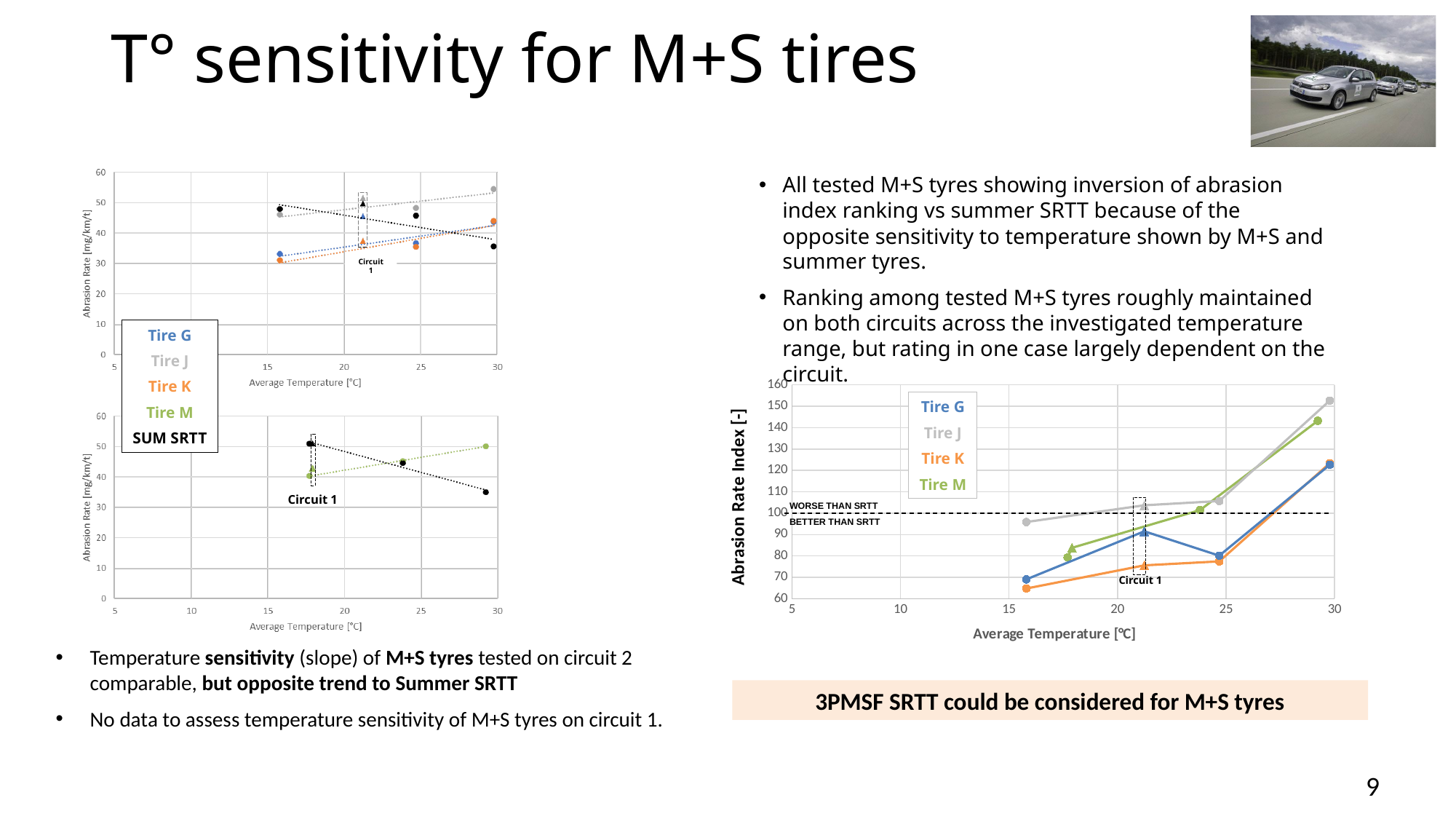
On the right-hand chart (Abrasion Rate Index), is the value for Tire M at about 30°C greater or less than 130? greater On the bottom-left chart (Abrasion Rate vs Average Temperature), does the Tire M series rise or fall as average temperature increases? Rise On the top-left chart (Abrasion Rate vs Average Temperature), does the SUM SRTT series rise or fall as average temperature increases? Fall On the right-hand chart (Abrasion Rate Index), what is the label of the x axis? Average Temperature [°C] On the right-hand chart (Abrasion Rate Index), is the value for Tire G at about 16°C greater or less than 80? less On the right-hand chart (Abrasion Rate Index), is the value for Tire K at about 16°C greater or less than 70? less On the right-hand chart (Abrasion Rate Index), do the Tire J values rise or fall as average temperature increases? Rise On the right-hand chart (Abrasion Rate Index), what kind of chart is it? Line chart On the right-hand chart (Abrasion Rate Index), at what index value is the dashed horizontal line separating 'WORSE THAN SRTT' from 'BETTER THAN SRTT' drawn? 100 On the right-hand chart (Abrasion Rate Index), how many tires does the legend list? 4